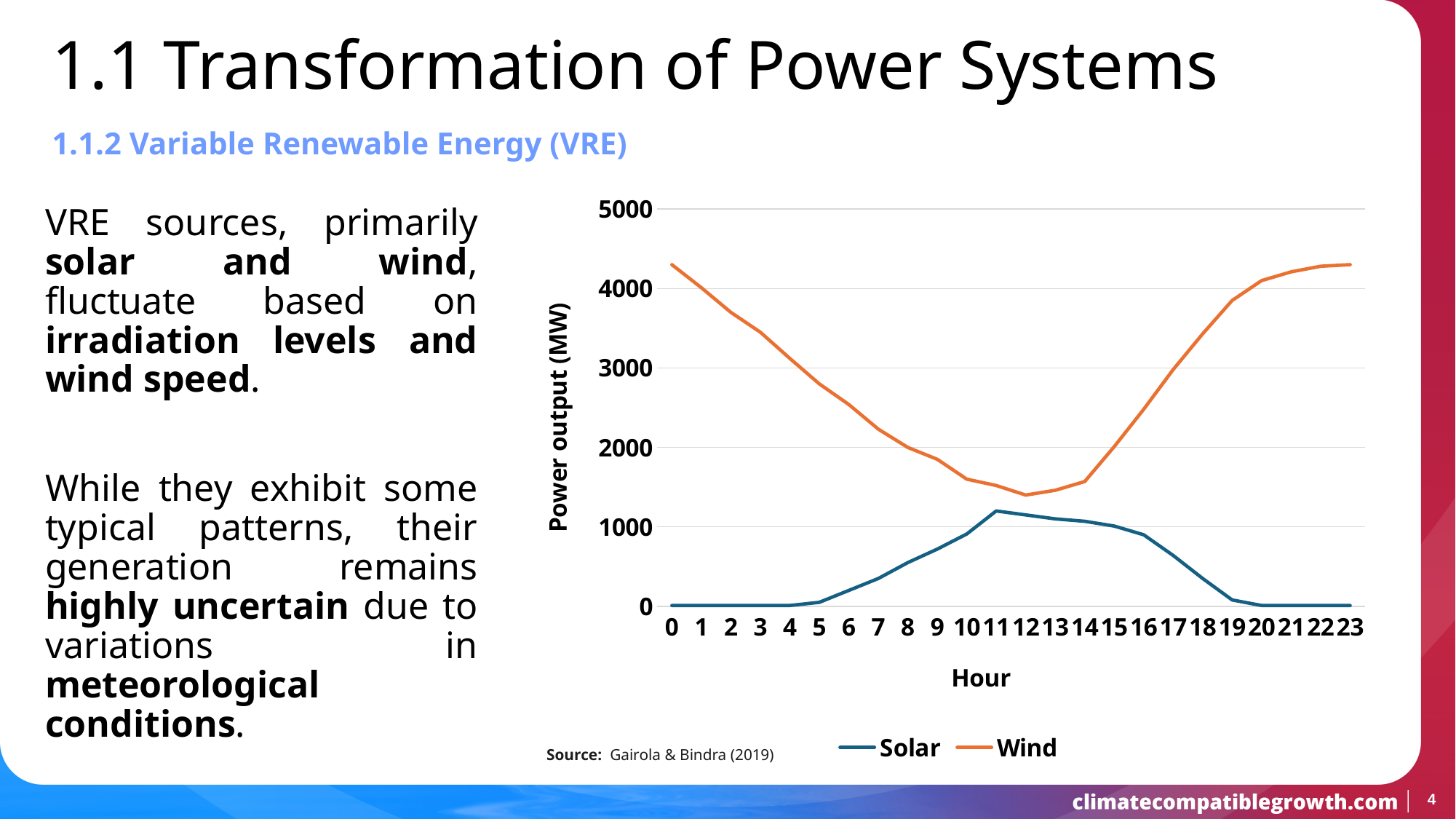
How many hours are plotted along the x axis? 24 What kind of chart is shown on the slide? line chart At which hour does the Solar series reach its highest value? 11 Which series has the larger value at hour 5, Solar or Wind? Wind What is the label of the y axis? Power output (MW) How many series does the legend list? 2 At which hour does the Wind series reach its lowest value? 12 Is the Solar value at hour 11 greater or less than 1000? greater Is the Wind value at hour 0 greater or less than 4000? greater Is the Wind value at hour 12 greater or less than 2000? less Does the Wind series rise or fall between hour 0 and hour 12? fall